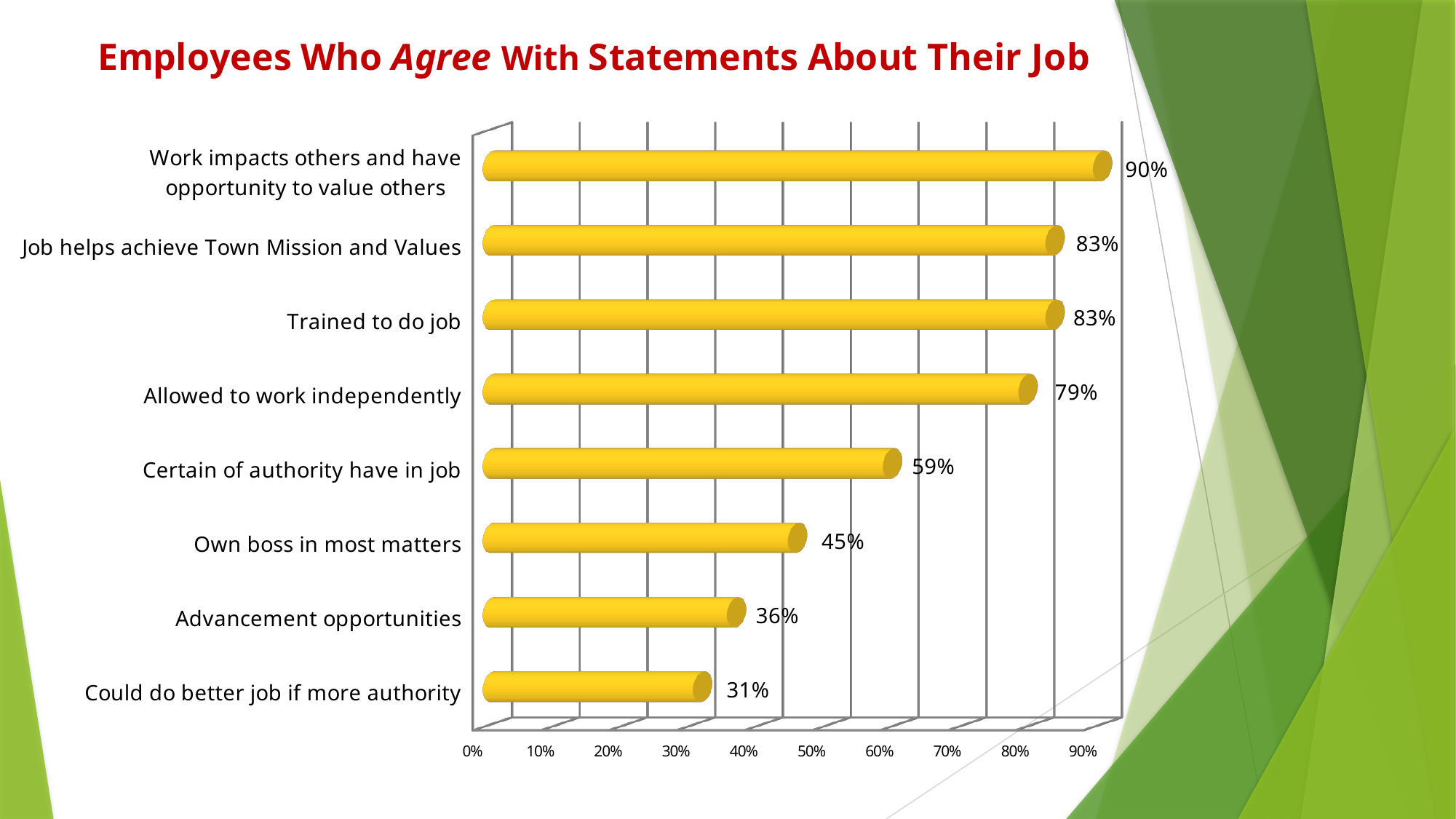
What is the difference between the values for "Allowed to work independently" and "Certain of authority have in job"? 20% Which statement has the lowest percentage of employees agreeing? Could do better job if more authority Which has a larger value: "Advancement opportunities" or "Own boss in most matters"? Own boss in most matters Is the value for "Certain of authority have in job" greater or less than 50%? greater What is the value for "Own boss in most matters"? 45% What kind of chart is shown on the slide? Bar chart How many statements are shown in the chart? 8 What percentage of employees agree that they are trained to do their job? 83% What percentage of employees agree with "Could do better job if more authority"? 31% What is the title of the chart on the slide? Employees Who Agree With Statements About Their Job Which statement has the highest percentage of employees agreeing? Work impacts others and have opportunity to value others What is the difference between the highest and lowest values in the chart? 59%